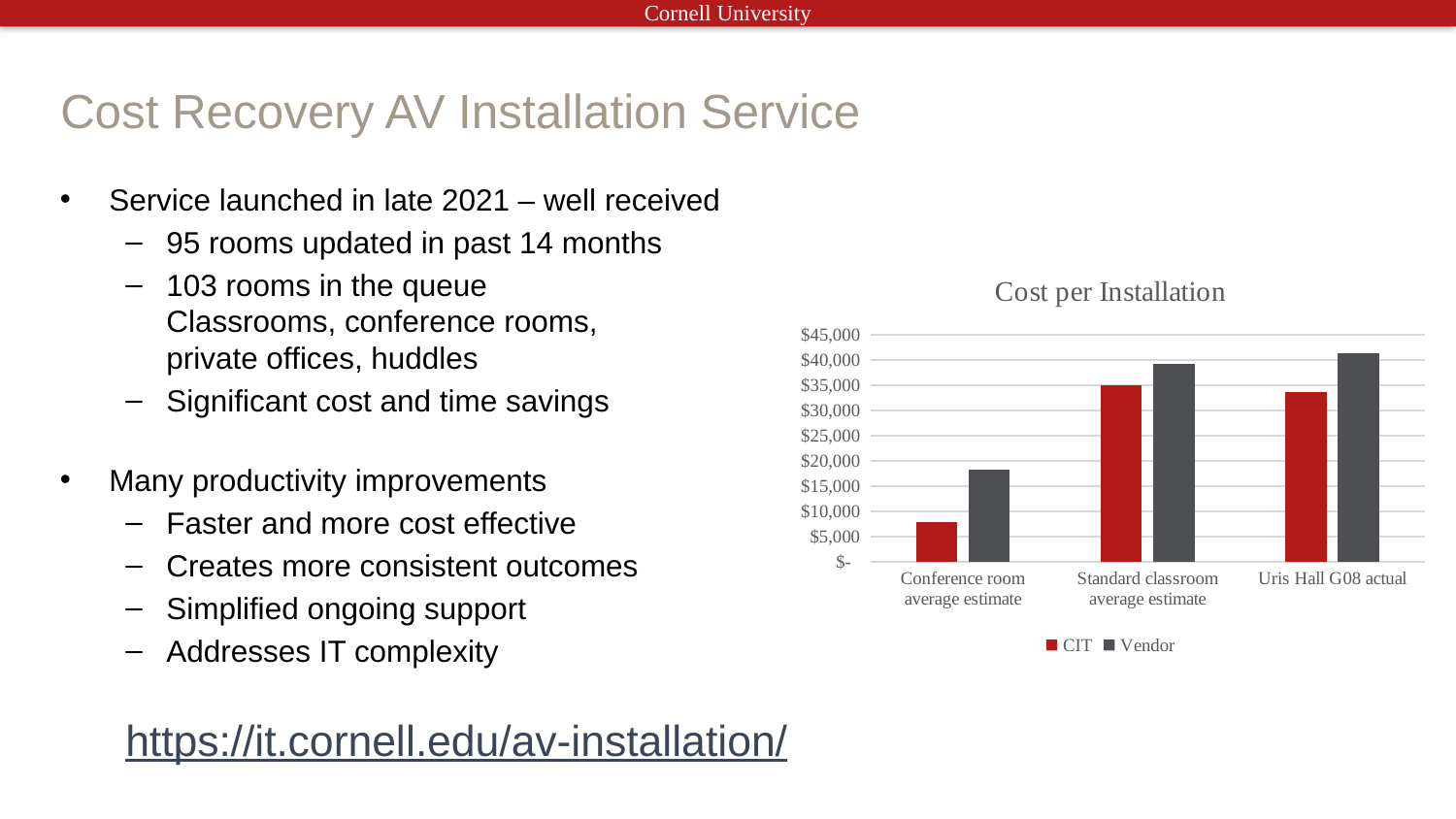
What is the title of the chart? Cost per Installation How many series does the chart's legend list? 2 What kind of chart is shown on the slide? bar chart For Uris Hall G08 actual, which is larger, the CIT value or the Vendor value? Vendor Is the Vendor value for Standard classroom average estimate greater or less than $35,000? greater Is the CIT value for Uris Hall G08 actual greater or less than $35,000? less Which series is shown in red in the chart? CIT How many categories are shown on the x axis of the chart? 3 Is the CIT value for Conference room average estimate greater or less than $10,000? less Which category has the highest Vendor value? Uris Hall G08 actual Which category has the lowest CIT value? Conference room average estimate